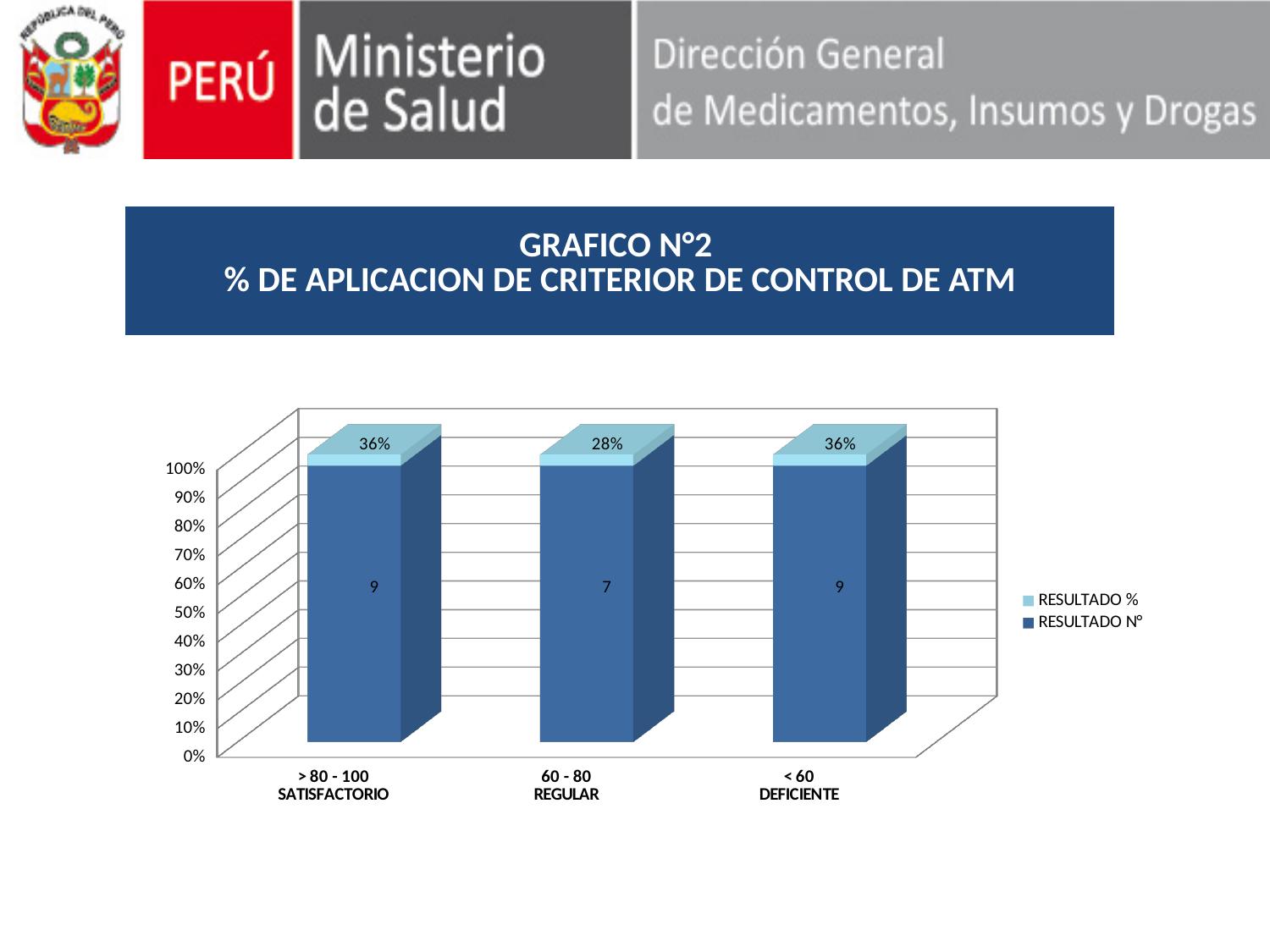
How many categories are shown on the x axis of the chart? 3 What is the RESULTADO % value for the < 60 DEFICIENTE category? 36% Which category has the lowest RESULTADO N° value? 60 - 80 REGULAR What is the RESULTADO N° value for the < 60 DEFICIENTE category? 9 What is the difference between the RESULTADO % values for < 60 DEFICIENTE and 60 - 80 REGULAR? 8% What is the difference between the RESULTADO N° values for > 80 - 100 SATISFACTORIO and 60 - 80 REGULAR? 2 What kind of chart is shown on the slide? Bar chart Which has a larger RESULTADO N° value, > 80 - 100 SATISFACTORIO or 60 - 80 REGULAR? > 80 - 100 SATISFACTORIO How many series does the chart legend list? 2 What is the RESULTADO N° value for the 60 - 80 REGULAR category? 7 Which category has the lowest RESULTADO % value? 60 - 80 REGULAR What is the RESULTADO % value for the > 80 - 100 SATISFACTORIO category? 36%